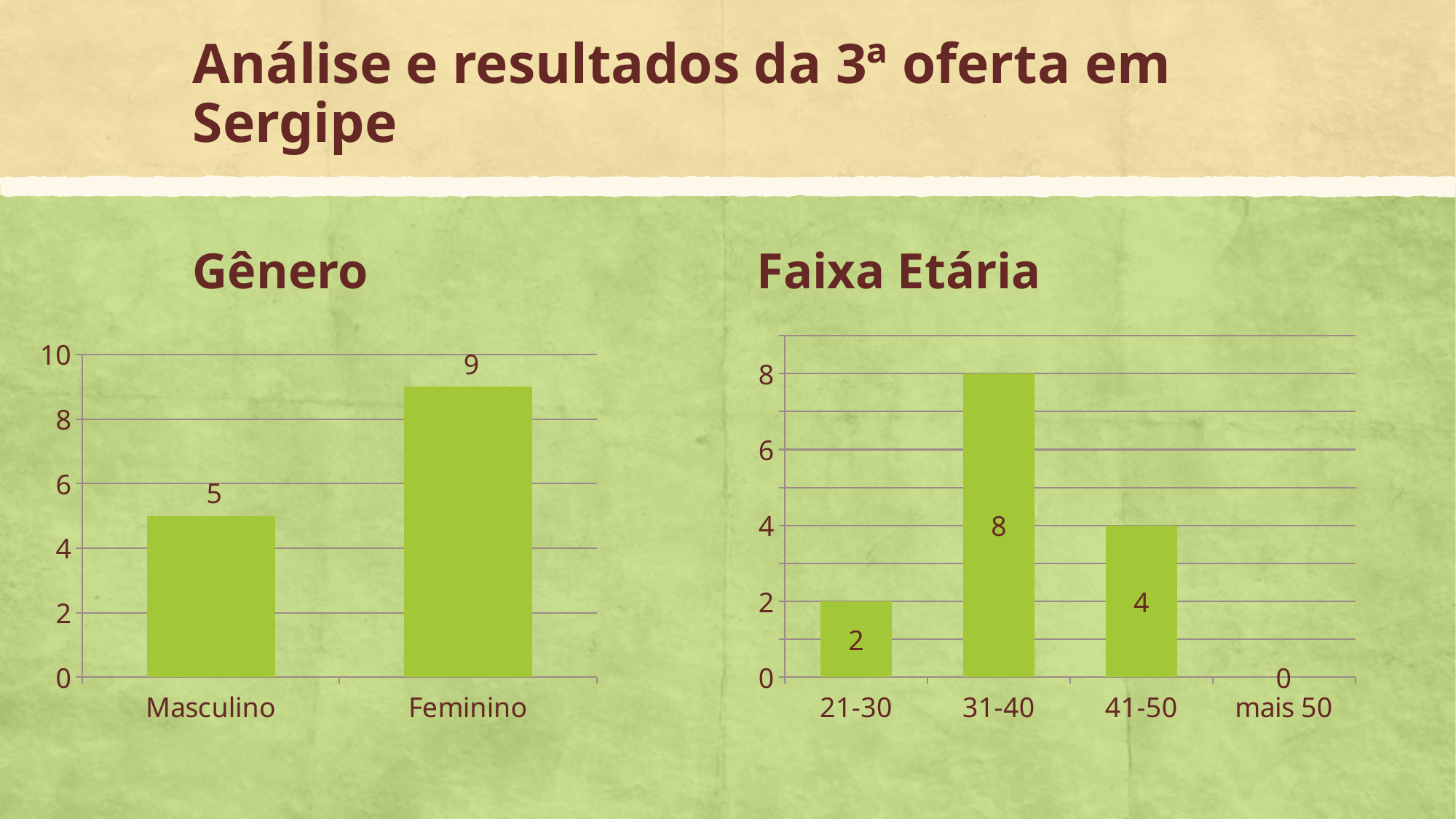
In the Gênero chart, what is the value for Masculino? 5 What type of chart is the Faixa Etária chart? Bar chart In the Gênero chart, which category has the higher value, Masculino or Feminino? Feminino In the Gênero chart, what is the difference between Feminino and Masculino? 4 In the Faixa Etária chart, how many age groups are shown? 4 In the Faixa Etária chart, what is the difference between 31-40 and 41-50? 4 In the Faixa Etária chart, which age group has the lowest value? mais 50 In the Gênero chart, how many categories are shown? 2 In the Faixa Etária chart, which age group has the highest value? 31-40 In the Faixa Etária chart, what is the value for mais 50? 0 In the Faixa Etária chart, what is the value for 31-40? 8 In the Gênero chart, what is the value for Feminino? 9